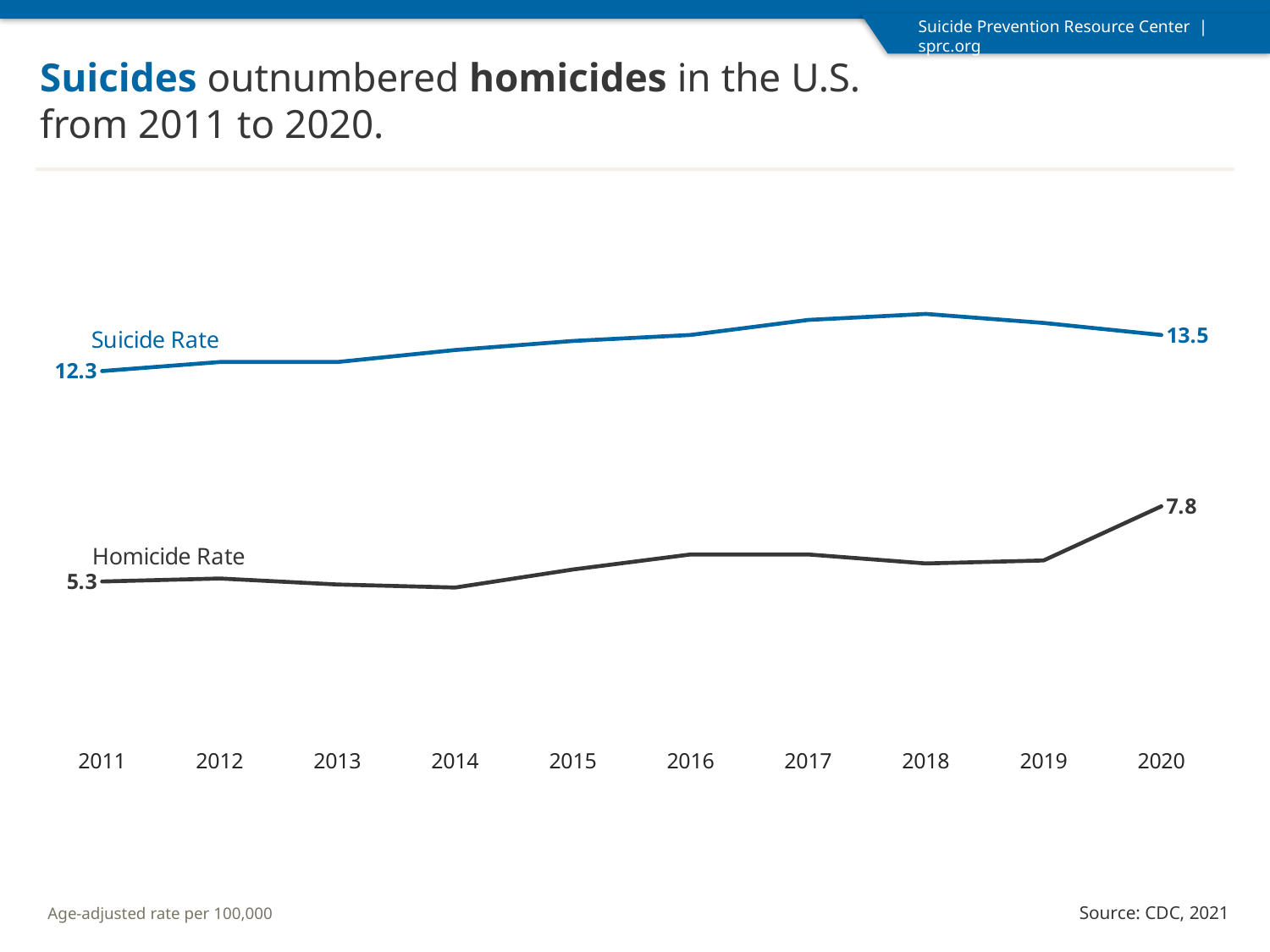
What was the Suicide Rate in 2011? 12.3 By how much did the Homicide Rate change from 2011 to 2020? 2.5 What was the Homicide Rate in 2011? 5.3 What type of chart is shown on the slide? Line chart What was the Homicide Rate in 2020? 7.8 What was the Suicide Rate in 2020? 13.5 Does the Homicide Rate rise or fall from 2019 to 2020? Rise By how much did the Suicide Rate change from 2011 to 2020? 1.2 How many years are shown on the x axis? 10 How many series are plotted on the chart? 2 What is the difference between the Suicide Rate and the Homicide Rate in 2020? 5.7 Which series has the higher value in 2020, Suicide Rate or Homicide Rate? Suicide Rate